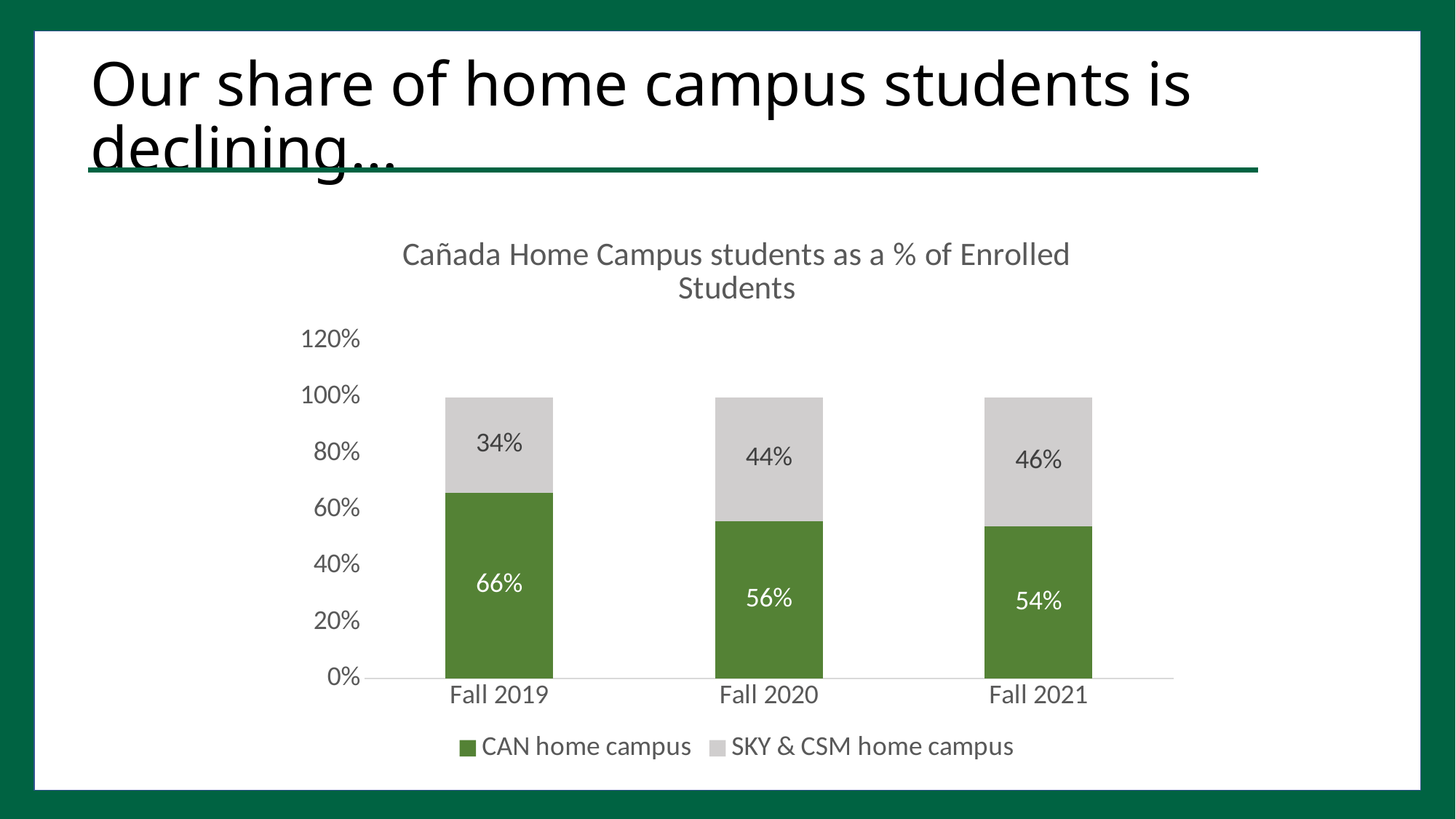
What is the difference between the CAN home campus share in Fall 2019 and Fall 2021? 12% Which is larger in Fall 2020: CAN home campus or SKY & CSM home campus? CAN home campus In which term is the SKY & CSM home campus share lowest? Fall 2019 What kind of chart is shown? Stacked bar chart What is the total of the stacked bar for Fall 2021? 100% What is the value for CAN home campus in Fall 2019? 66% What is the value for SKY & CSM home campus in Fall 2020? 44% Does the CAN home campus share rise or fall from Fall 2019 to Fall 2021? Fall How many terms are shown on the x axis? 3 How many series does the legend list? 2 In which term is the CAN home campus share highest? Fall 2019 What is the value for CAN home campus in Fall 2021? 54%